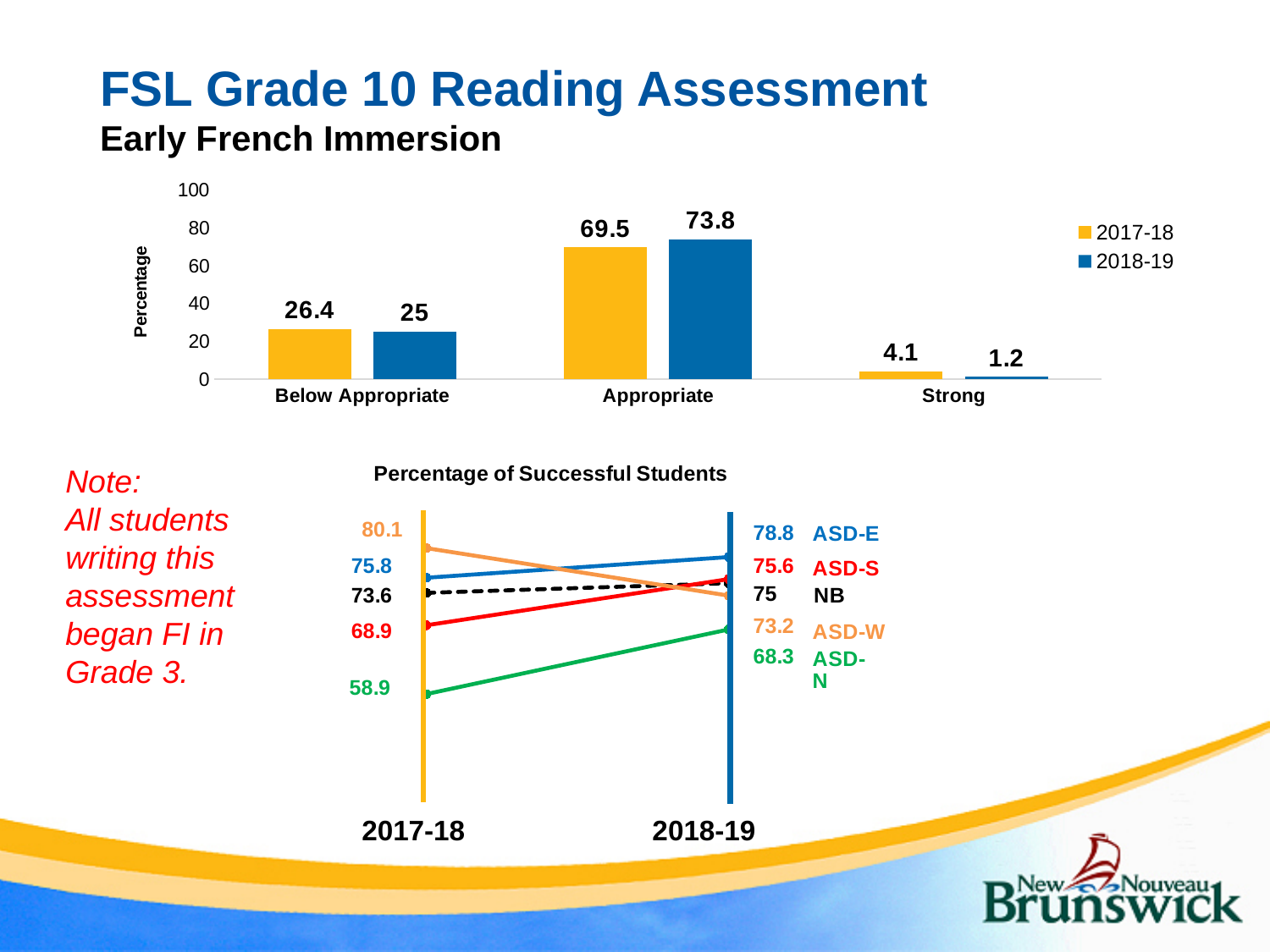
In the top bar chart, which category has the lowest value for 2018-19? Strong In the Percentage of Successful Students chart, which district has the highest value in 2018-19? ASD-E In the top bar chart, which is larger for Strong: the 2017-18 value or the 2018-19 value? 2017-18 In the top bar chart, what is the value for Below Appropriate in 2017-18? 26.4 How many categories are shown on the x axis of the top bar chart? 3 How many series does the legend of the top bar chart list? 2 What kind of chart is the top chart on the slide? Bar chart In the top bar chart, what is the value for Appropriate in 2018-19? 73.8 In the top bar chart, what is the difference between the 2018-19 and 2017-18 values for Appropriate? 4.3 In the Percentage of Successful Students chart, what is the difference between the NB values for 2018-19 and 2017-18? 1.4 In the Percentage of Successful Students chart, does the value for ASD-N rise or fall from 2017-18 to 2018-19? Rise In the Percentage of Successful Students chart, what is the value for ASD-W in 2017-18? 80.1